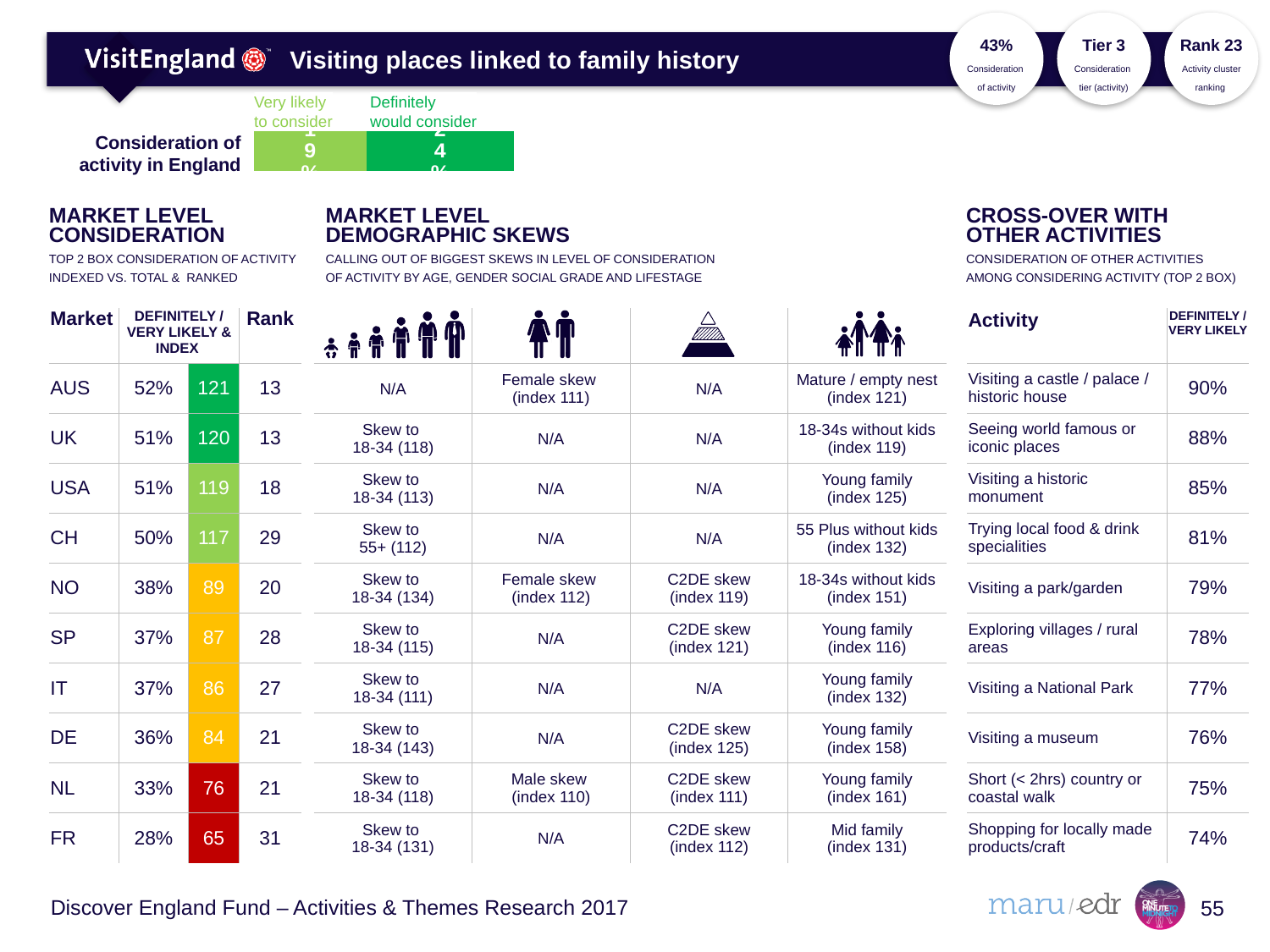
What kind of chart is the 'Consideration of activity in England' chart? Stacked bar chart What are the two segments of the 'Consideration of activity in England' bar labelled? Very likely to consider; Definitely would consider What is the total of the 'Consideration of activity in England' stacked bar? 43% In the 'Consideration of activity in England' bar, which segment is larger: 'Very likely to consider' or 'Definitely would consider'? Definitely would consider How many segments (series) make up the 'Consideration of activity in England' bar? 2 In the 'Consideration of activity in England' bar, what is the value for 'Definitely would consider'? 24% In the 'Consideration of activity in England' bar, what is the value for 'Very likely to consider'? 19% What is the difference between 'Definitely would consider' and 'Very likely to consider' in the 'Consideration of activity in England' bar? 5% Which colour is used for the 'Definitely would consider' segment in the 'Consideration of activity in England' bar? Dark green